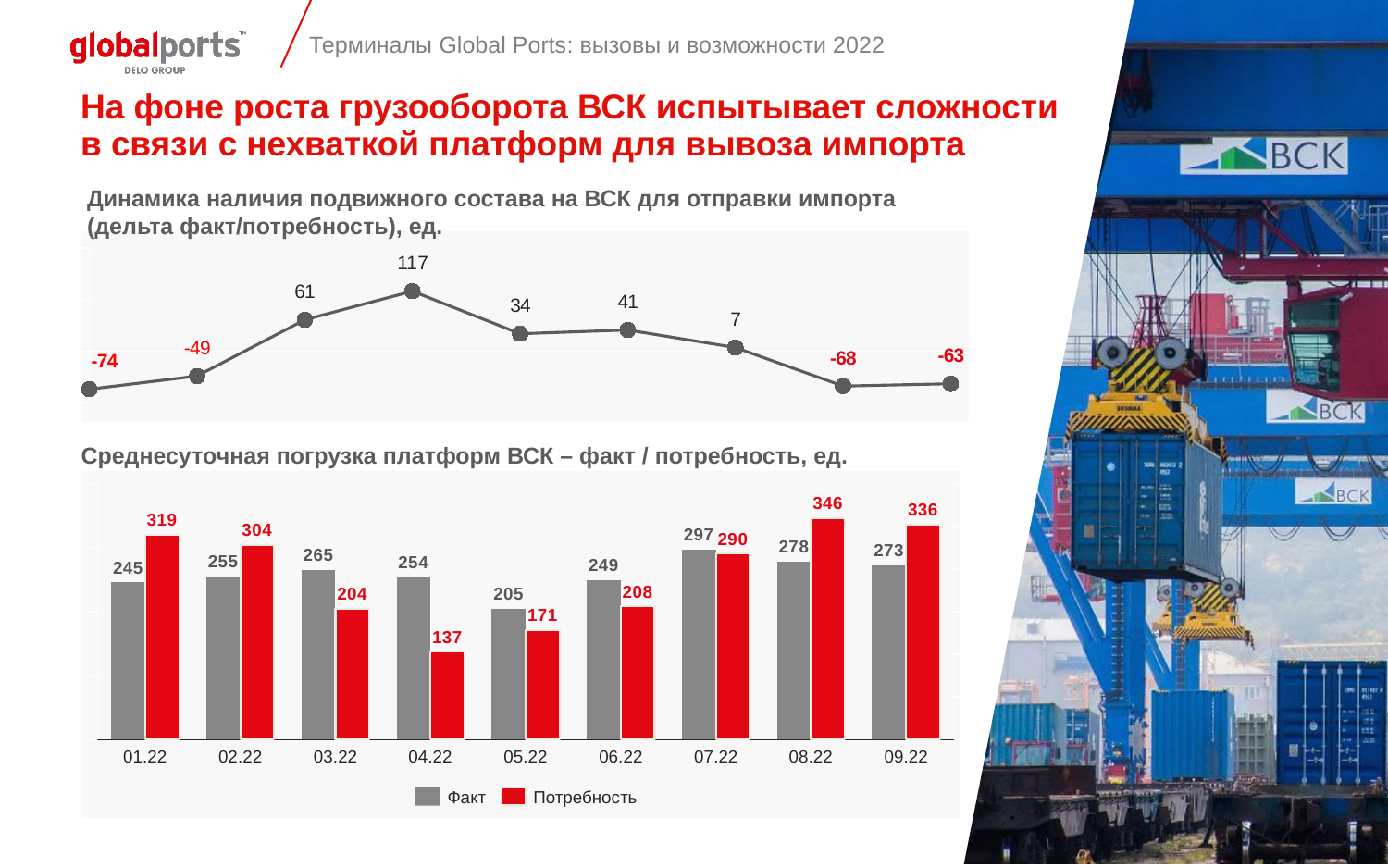
In the bottom chart (Среднесуточная погрузка платформ ВСК), what is the Факт value for 04.22? 254 In the bottom chart (Среднесуточная погрузка платформ ВСК), what is the Потребность value for 08.22? 346 What type of chart is the bottom chart (Среднесуточная погрузка платформ ВСК)? Bar chart In the bottom chart (Среднесуточная погрузка платформ ВСК), which month has the highest Факт value? 07.22 In the bottom chart (Среднесуточная погрузка платформ ВСК), which month has the lowest Потребность value? 04.22 In the bottom chart (Среднесуточная погрузка платформ ВСК), what is the difference between Потребность and Факт in 01.22? 74 In the top chart (Динамика наличия подвижного состава на ВСК), what is the lowest value plotted? -74 In the bottom chart (Среднесуточная погрузка платформ ВСК), how many series does the legend list? 2 In the top chart (Динамика наличия подвижного состава на ВСК), what is the highest value plotted? 117 What type of chart is the top chart (Динамика наличия подвижного состава на ВСК)? Line chart In the bottom chart (Среднесуточная погрузка платформ ВСК), which is larger in 05.22: Факт or Потребность? Факт In the bottom chart (Среднесуточная погрузка платформ ВСК), how many months are shown on the x axis? 9